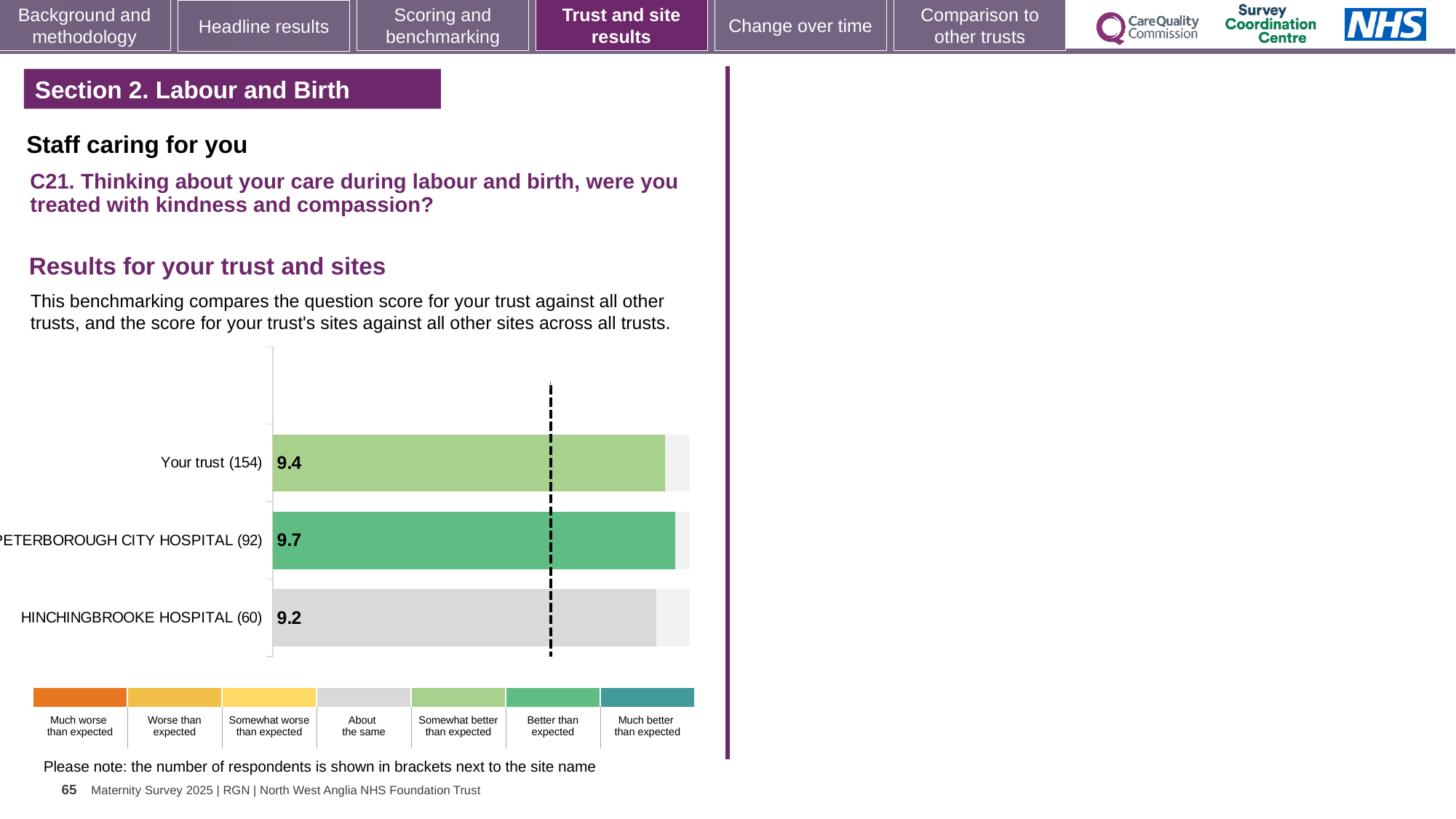
What is the score for Your trust (154)? 9.4 What is the difference between the scores for PETERBOROUGH CITY HOSPITAL (92) and HINCHINGBROOKE HOSPITAL (60)? 0.5 How many benchmark categories does the colour key below the chart list? 7 What kind of chart is shown on the slide? Bar chart Which site or trust has the highest score? PETERBOROUGH CITY HOSPITAL (92) According to the colour key, which benchmark category does the grey bar for HINCHINGBROOKE HOSPITAL (60) represent? About the same What is the score for PETERBOROUGH CITY HOSPITAL (92)? 9.7 Which site or trust has the lowest score? HINCHINGBROOKE HOSPITAL (60) How many bars are shown in the chart? 3 What is the score for HINCHINGBROOKE HOSPITAL (60)? 9.2 What is the difference between the scores for PETERBOROUGH CITY HOSPITAL (92) and Your trust (154)? 0.3 Which has a higher score, Your trust (154) or HINCHINGBROOKE HOSPITAL (60)? Your trust (154)